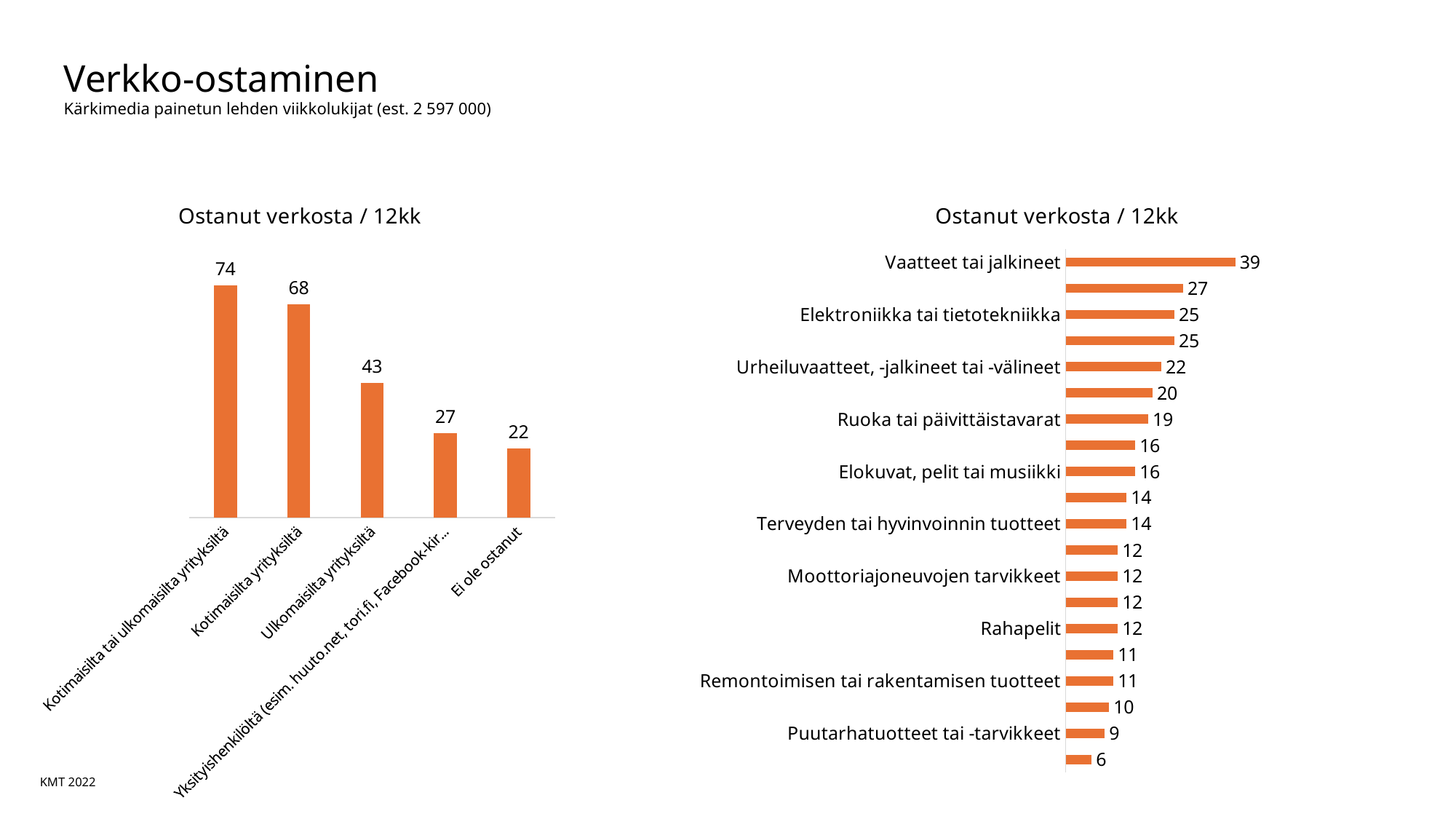
What kind of chart is the right chart? bar chart On the left chart, what is the difference between Kotimaisilta yrityksiltä and Ulkomaisilta yrityksiltä? 25 On the right chart, which is larger: Elektroniikka tai tietotekniikka or Urheiluvaatteet, -jalkineet tai -välineet? Elektroniikka tai tietotekniikka On the left chart, what is the value for Ei ole ostanut? 22 On the left chart, do the values rise or fall from left to right? fall On the right chart, what is the value for Ruoka tai päivittäistavarat? 19 On the right chart, what is the difference between Vaatteet tai jalkineet and Puutarhatuotteet tai -tarvikkeet? 30 On the left chart, how many bars are plotted? 5 On the left chart, which category has the lowest value? Ei ole ostanut On the left chart, what is the value for Kotimaisilta yrityksiltä? 68 On the left chart, which category has the highest value? Kotimaisilta tai ulkomaisilta yrityksiltä On the right chart, what is the value for Vaatteet tai jalkineet? 39